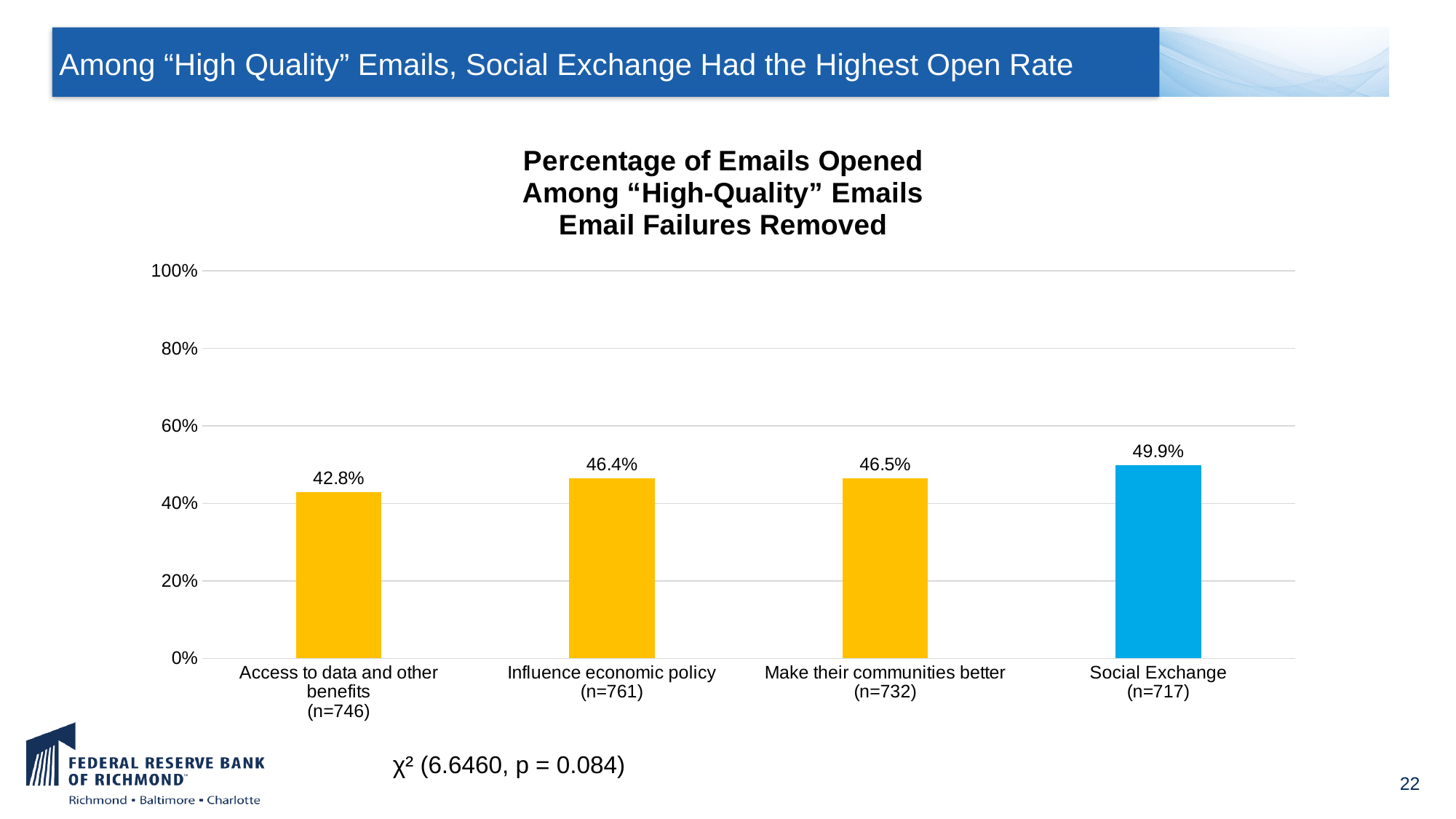
Which category has the highest percentage of emails opened? Social Exchange How many categories are shown in the chart? 4 Which category has the lowest percentage of emails opened? Access to data and other benefits What is the sample size (n) shown for the Social Exchange category? 717 Which has a higher open rate, Social Exchange or Influence economic policy? Social Exchange What is the percentage of emails opened for Make their communities better? 46.5% Is the open rate for Social Exchange greater or less than 60%? less What is the percentage of emails opened for Social Exchange? 49.9% What is the percentage of emails opened for Influence economic policy? 46.4% What kind of chart is shown on the slide? bar chart What is the difference in open rate between Social Exchange and Access to data and other benefits? 7.1% What is the percentage of emails opened for Access to data and other benefits? 42.8%